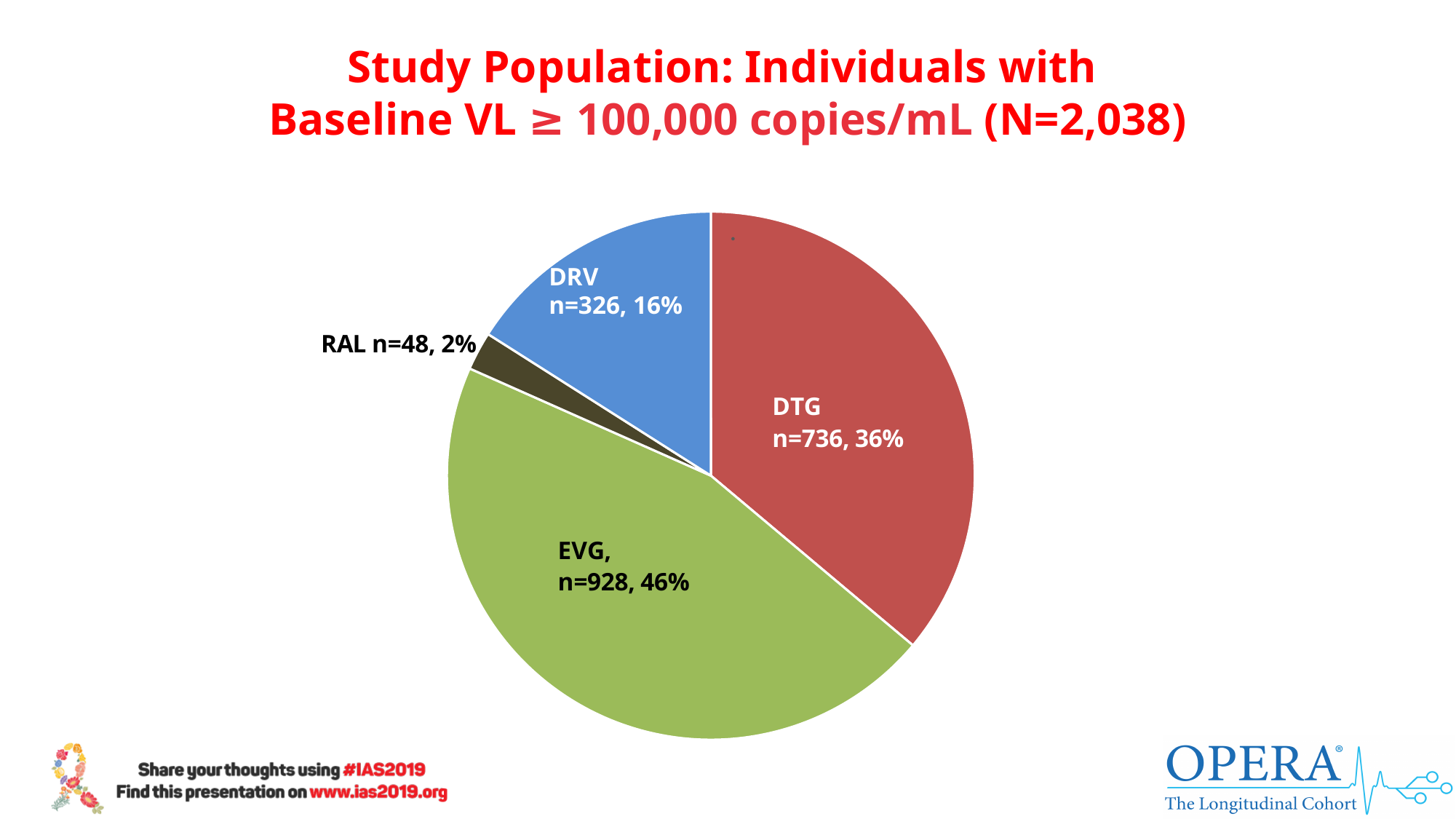
What is the n value for the DRV slice? n=326 What is the difference in percentage share between DTG and DRV? 20% Which has a larger n, DRV or RAL? DRV How many slices does the pie chart have? 4 Which slice is the smallest? RAL What percentage of the pie does RAL represent? 2% What percentage of the pie does EVG represent? 46% What is the n value for the DTG slice? n=736 What kind of chart is shown on the slide? pie chart What is the difference in n between EVG and DTG? 192 What colour is the EVG slice? green Which slice is the largest? EVG